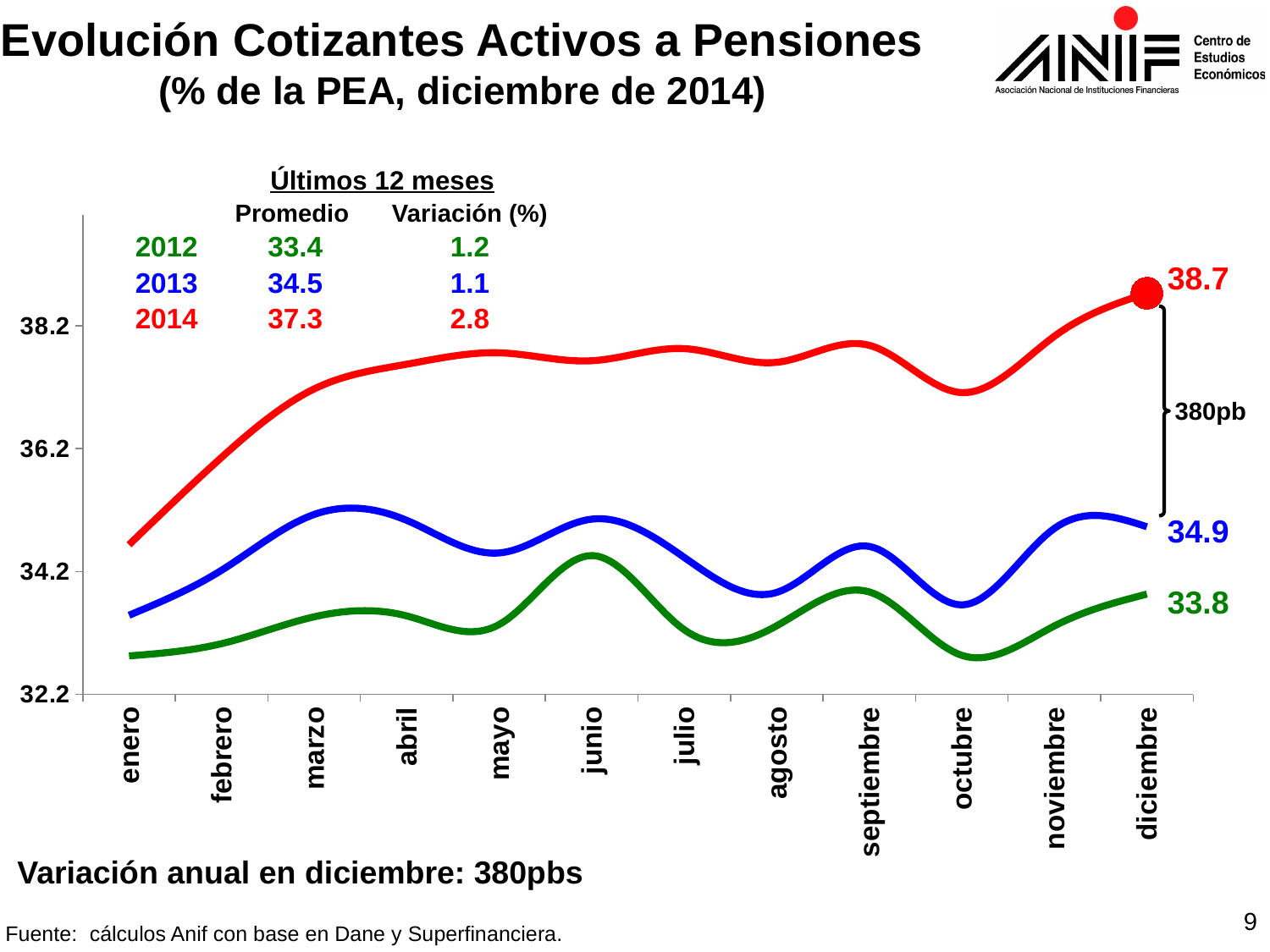
What is the value for 2014 in diciembre? 38.7 What is the value for 2013 in diciembre? 34.9 What is the difference between the diciembre values for 2013 and 2012? 1.1 Which year has the highest value in diciembre? 2014 What kind of chart is shown on the slide? line chart What is the value for 2012 in diciembre? 33.8 How many months are shown on the x axis? 12 Does the 2014 line rise or fall from enero to diciembre? rise What is the difference between the diciembre values for 2014 and 2013? 3.8 Is the value for 2012 in enero greater or less than 34.2? less How many series (years) are plotted on the chart? 3 Is the value for 2014 in octubre greater or less than 36.2? greater